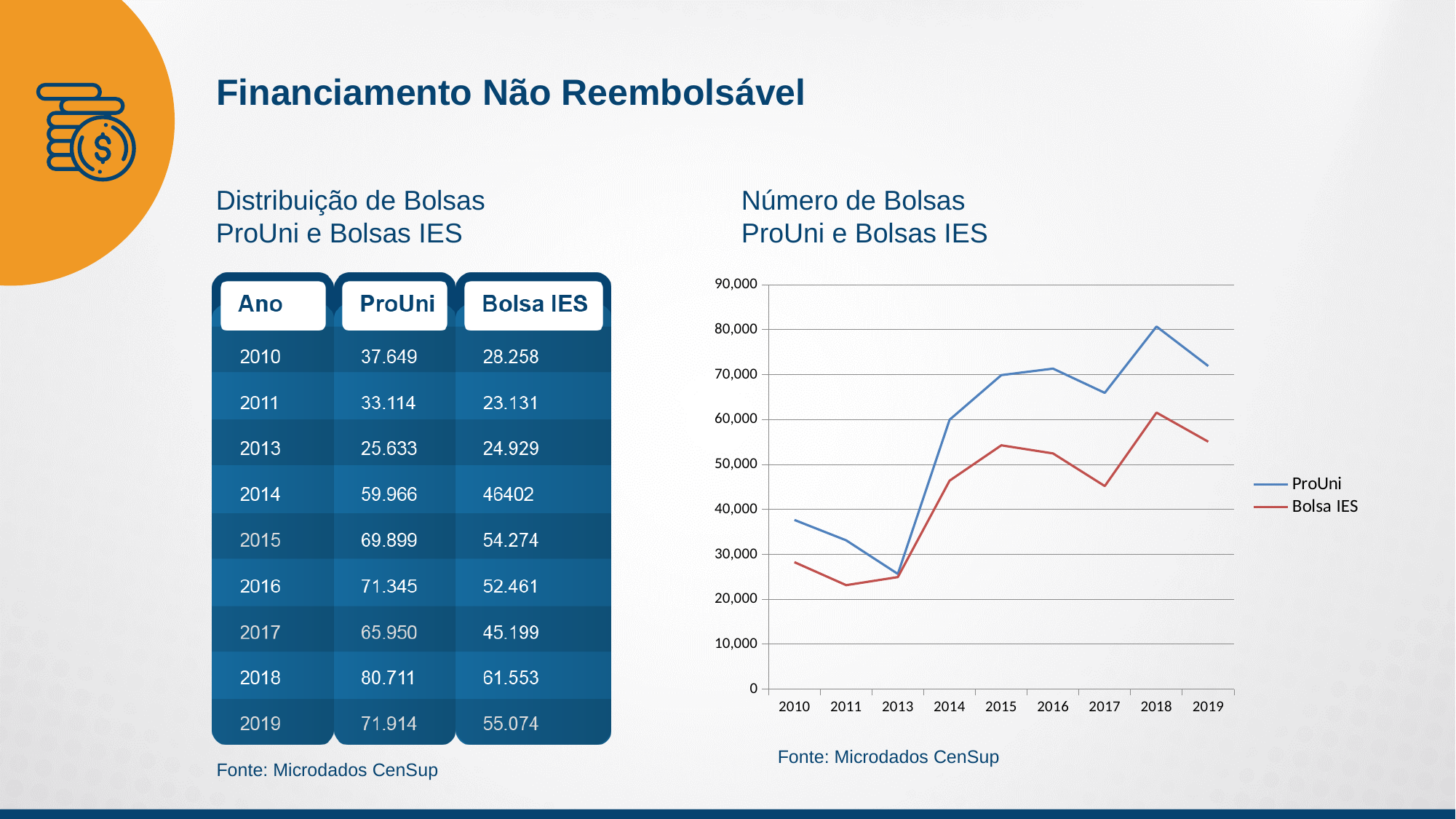
In the line chart, in which year is the ProUni series at its lowest? 2013 How many years are plotted along the x axis of the line chart? 9 In the line chart, which series has the higher value in 2019, ProUni or Bolsa IES? ProUni In the line chart, is the ProUni value for 2014 greater or less than 50,000? greater In the line chart, what colour is the ProUni line? blue How many series does the legend of the line chart list? 2 In the line chart, in which year does the ProUni series reach its highest value? 2018 In the line chart, is the Bolsa IES value for 2017 greater or less than 50,000? less In the line chart, in which year is the Bolsa IES series at its lowest? 2011 In the line chart, does the ProUni series rise or fall from 2010 to 2013? fall What kind of chart is shown under the title 'Número de Bolsas ProUni e Bolsas IES'? line chart In the line chart, in which year does the Bolsa IES series peak? 2018